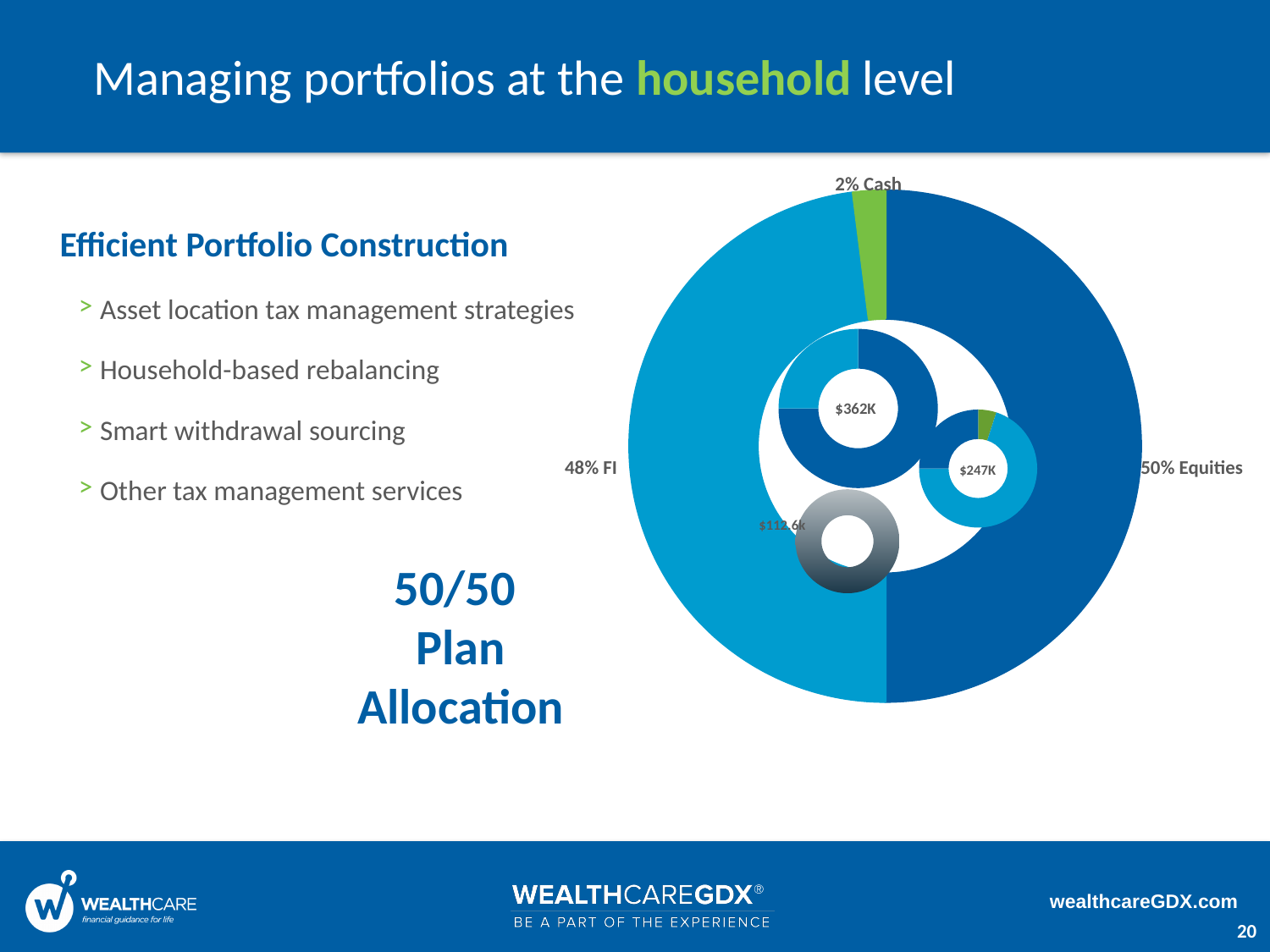
In the large pie chart, what is the difference between the FI share and the Cash share? 46% What kind of chart is the large chart on the right of the slide? doughnut chart What colour is the Cash slice in the large pie chart? green In the large pie chart, what share is labelled for FI? 48% In the large pie chart, what share is labelled for Equities? 50% How many slices does the large pie chart have? 3 Which slice of the large pie chart is the smallest? Cash Which slice of the large pie chart is the largest? Equities In the large pie chart, what is the difference between the Equities share and the FI share? 2% What value is printed in the centre of the largest inner donut chart? $362K In the large pie chart, which is larger, the Equities slice or the FI slice? Equities In the large pie chart, what share is labelled for Cash? 2%